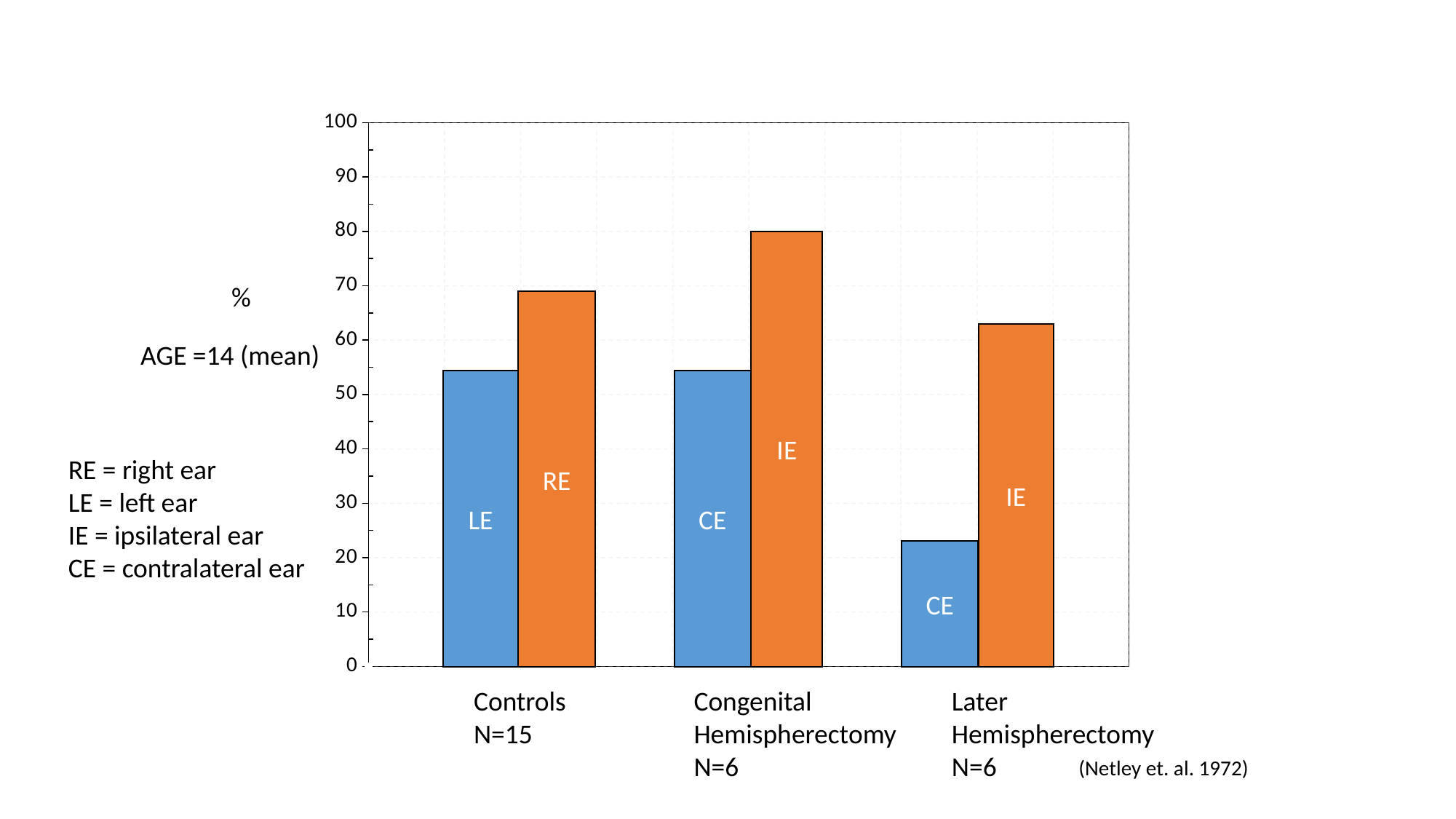
Is the value for CE in the Later Hemispherectomy group greater or less than 30? less Is the value for IE in the Later Hemispherectomy group greater or less than 70? less What is the sample size (N) shown for the Controls group? N=15 What is the value of the IE bar for Congenital Hemispherectomy? 80 Is the value for LE in the Controls group greater or less than 50? greater Which bar is the tallest in the chart? IE for Congenital Hemispherectomy In the Controls group, which is larger, the RE bar or the LE bar? RE In the Later Hemispherectomy group, which is larger, the CE bar or the IE bar? IE What kind of chart is shown on the slide? bar chart How many groups are shown along the x axis of the chart? 3 Which bar is the shortest in the chart? CE for Later Hemispherectomy